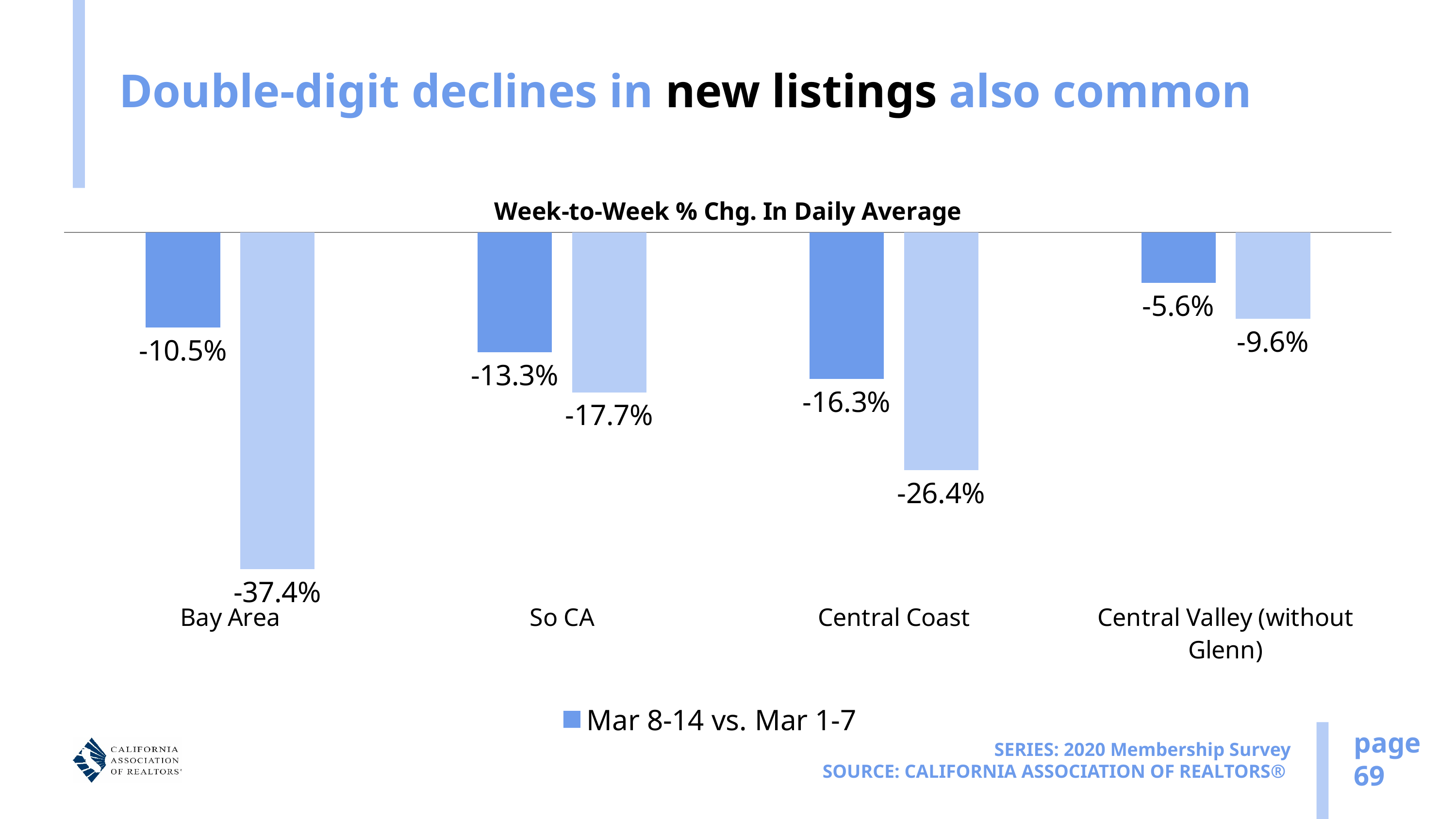
What is the difference in percentage points between the Mar 8-14 vs. Mar 1-7 values for Central Coast (-16.3%) and the Bay Area (-10.5%)? 5.8 percentage points What is the Mar 8-14 vs. Mar 1-7 value for So CA? -13.3% What is the Mar 8-14 vs. Mar 1-7 value for Central Valley (without Glenn)? -5.6% What is the Mar 8-14 vs. Mar 1-7 value for Central Coast? -16.3% Which region has the smallest decline in the Mar 8-14 vs. Mar 1-7 series? Central Valley (without Glenn) What is the Mar 8-14 vs. Mar 1-7 value for the Bay Area? -10.5% In the Mar 8-14 vs. Mar 1-7 series, which region shows a larger decline: So CA or Central Coast? Central Coast Which region has the largest decline in the Mar 8-14 vs. Mar 1-7 series? Central Coast What kind of chart is shown on the slide? Bar chart How many series does the chart's legend list? 1 What is the title of the chart? Week-to-Week % Chg. In Daily Average How many regions (categories) are shown on the x axis of the chart? 4